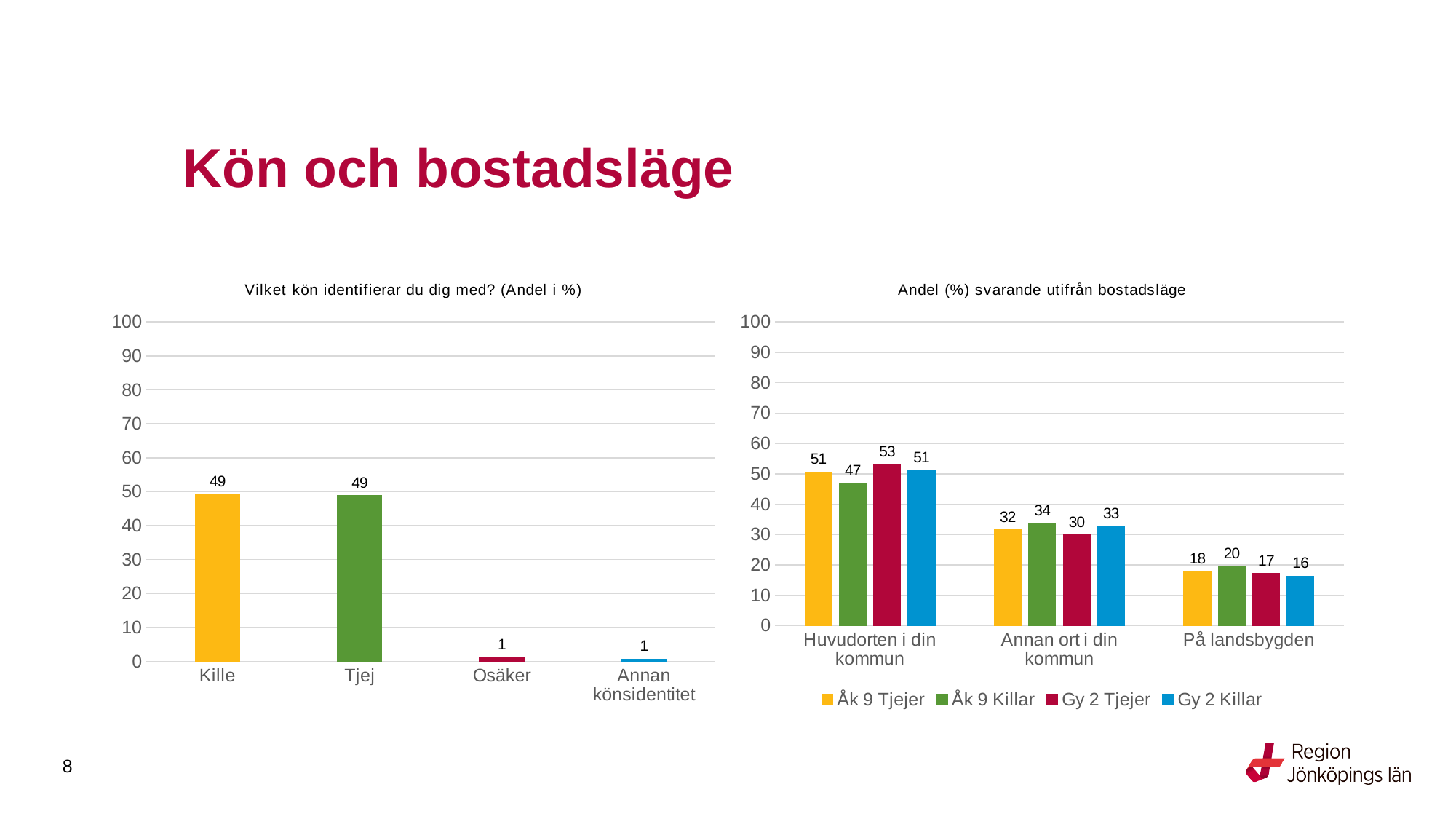
What kind of chart is the left chart 'Vilket kön identifierar du dig med? (Andel i %)'? Bar chart In the right chart 'Andel (%) svarande utifrån bostadsläge', what is the value for Åk 9 Killar in På landsbygden? 20 In the right chart 'Andel (%) svarande utifrån bostadsläge', which series has the lowest value in På landsbygden? Gy 2 Killar In the left chart 'Vilket kön identifierar du dig med? (Andel i %)', what is the value for Osäker? 1 In the left chart 'Vilket kön identifierar du dig med? (Andel i %)', what is the difference between the values for Tjej and Annan könsidentitet? 48 In the right chart 'Andel (%) svarande utifrån bostadsläge', what is the value for Gy 2 Tjejer in Huvudorten i din kommun? 53 In the left chart 'Vilket kön identifierar du dig med? (Andel i %)', how many categories are shown on the x axis? 4 In the left chart 'Vilket kön identifierar du dig med? (Andel i %)', what is the value for Kille? 49 In the right chart 'Andel (%) svarande utifrån bostadsläge', which colour represents Åk 9 Tjejer in the legend? Yellow In the right chart 'Andel (%) svarande utifrån bostadsläge', what is the difference between Åk 9 Killar and Gy 2 Tjejer in Annan ort i din kommun? 4 In the right chart 'Andel (%) svarande utifrån bostadsläge', how many series does the legend list? 4 In the right chart 'Andel (%) svarande utifrån bostadsläge', which series has the highest value in Huvudorten i din kommun? Gy 2 Tjejer